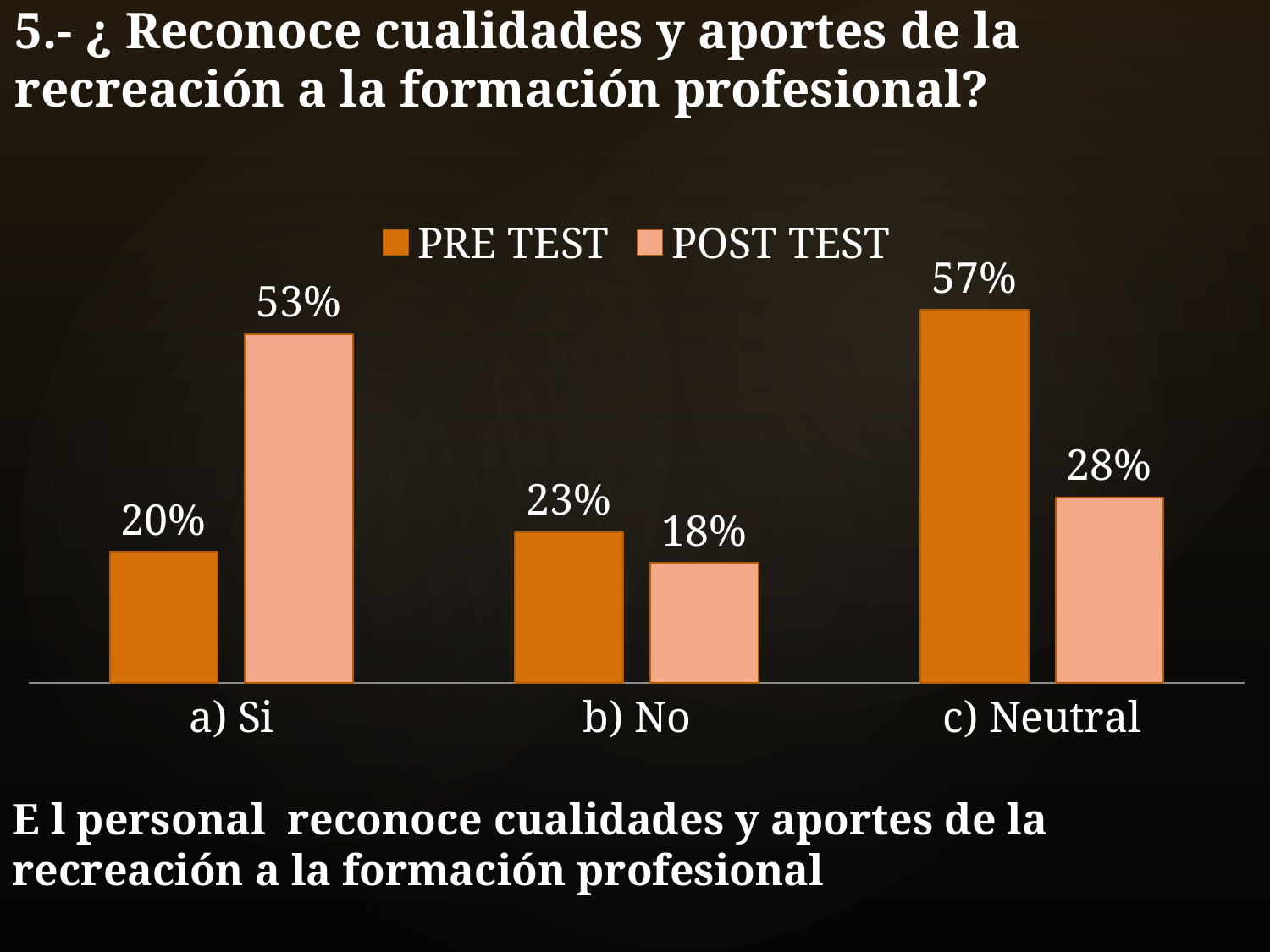
What is the PRE TEST value for c) Neutral? 57% What kind of chart is shown on the slide? Bar chart What is the POST TEST value for b) No? 18% What is the PRE TEST value for a) Si? 20% How many categories are shown on the x axis? 3 Which category has the lowest POST TEST value? b) No What is the difference between the POST TEST and PRE TEST values for a) Si? 33% Which category has the highest PRE TEST value? c) Neutral What are the two series named in the legend? PRE TEST and POST TEST What is the POST TEST value for a) Si? 53% How many series does the legend list? 2 Which is larger for c) Neutral, the PRE TEST or the POST TEST value? PRE TEST